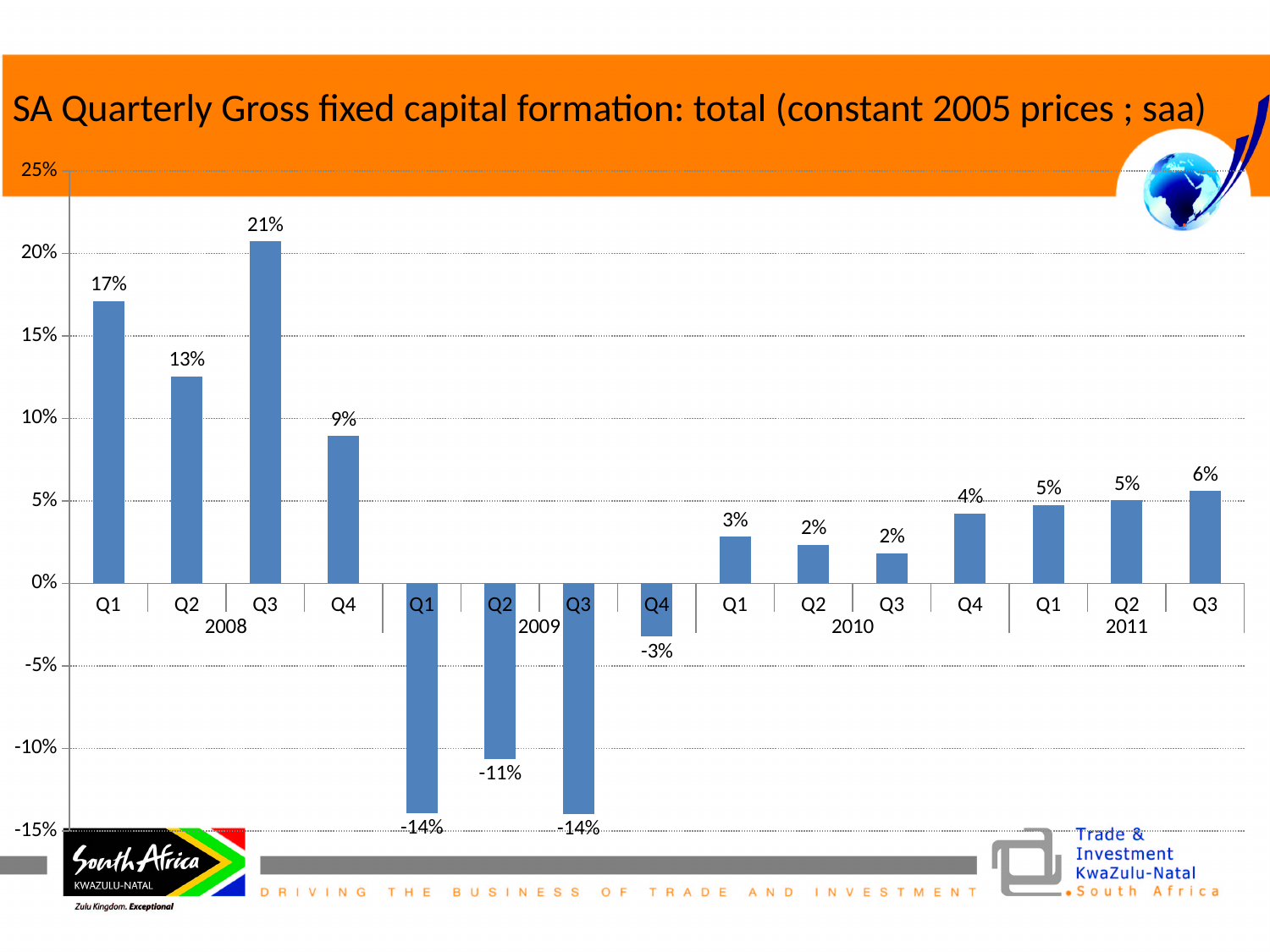
What is the difference between the values for Q1 2008 and Q2 2008? 4 percentage points What is the value for Q3 2011? 6% What is the value for Q4 2009? -3% Is the value for Q4 2008 greater or less than 10%? less What is the title of the chart? SA Quarterly Gross fixed capital formation: total (constant 2005 prices ; saa) Which is larger, the value for Q1 2008 or the value for Q4 2008? Q1 2008 Do the values rise or fall from Q4 2010 to Q3 2011? rise How many quarterly bars are plotted on the chart? 15 What kind of chart is shown on the slide? bar chart What is the value for Q2 2009? -11% Which quarter has the highest value? Q3 2008 What is the value for Q3 2008? 21%